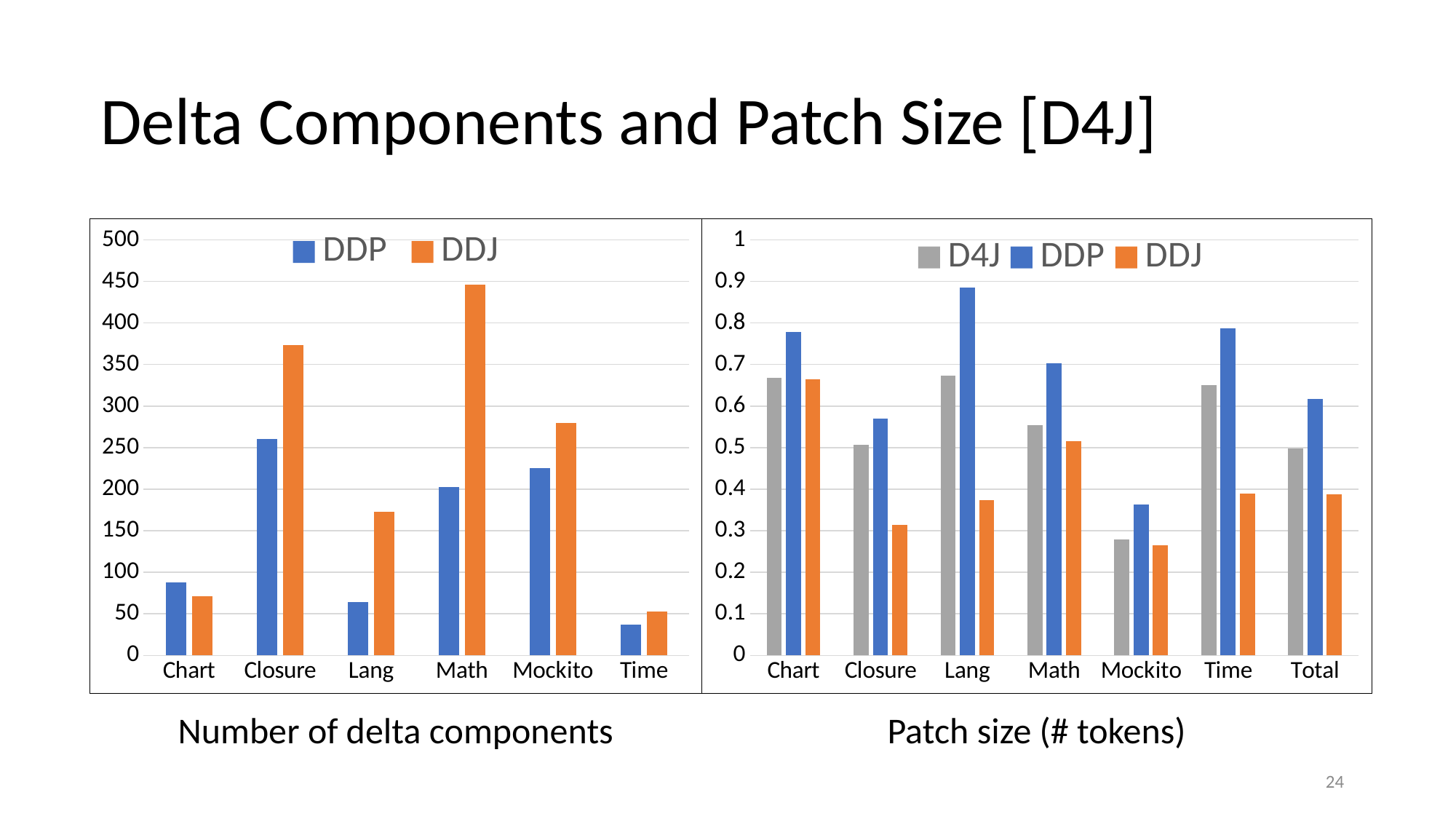
In the 'Number of delta components' chart, which is larger for Closure, DDP or DDJ? DDJ How many series does the legend of the 'Patch size (# tokens)' chart list? 3 In the 'Patch size (# tokens)' chart, which category has the lowest DDJ value? Mockito How many categories are shown on the x axis of the 'Number of delta components' chart? 6 In the 'Number of delta components' chart, which category has the highest DDJ value? Math In the 'Patch size (# tokens)' chart, which is larger for Time, D4J or DDP? DDP In the 'Number of delta components' chart, is the DDP value for Lang greater or less than 100? less In the 'Number of delta components' chart, is the DDJ value for Math greater or less than 400? greater What kind of chart is the 'Patch size (# tokens)' chart? bar chart In the 'Patch size (# tokens)' chart, which category has the highest DDP value? Lang In the 'Patch size (# tokens)' chart, is the DDJ value for Closure greater or less than 0.4? less In the 'Number of delta components' chart, which category has the lowest DDP value? Time